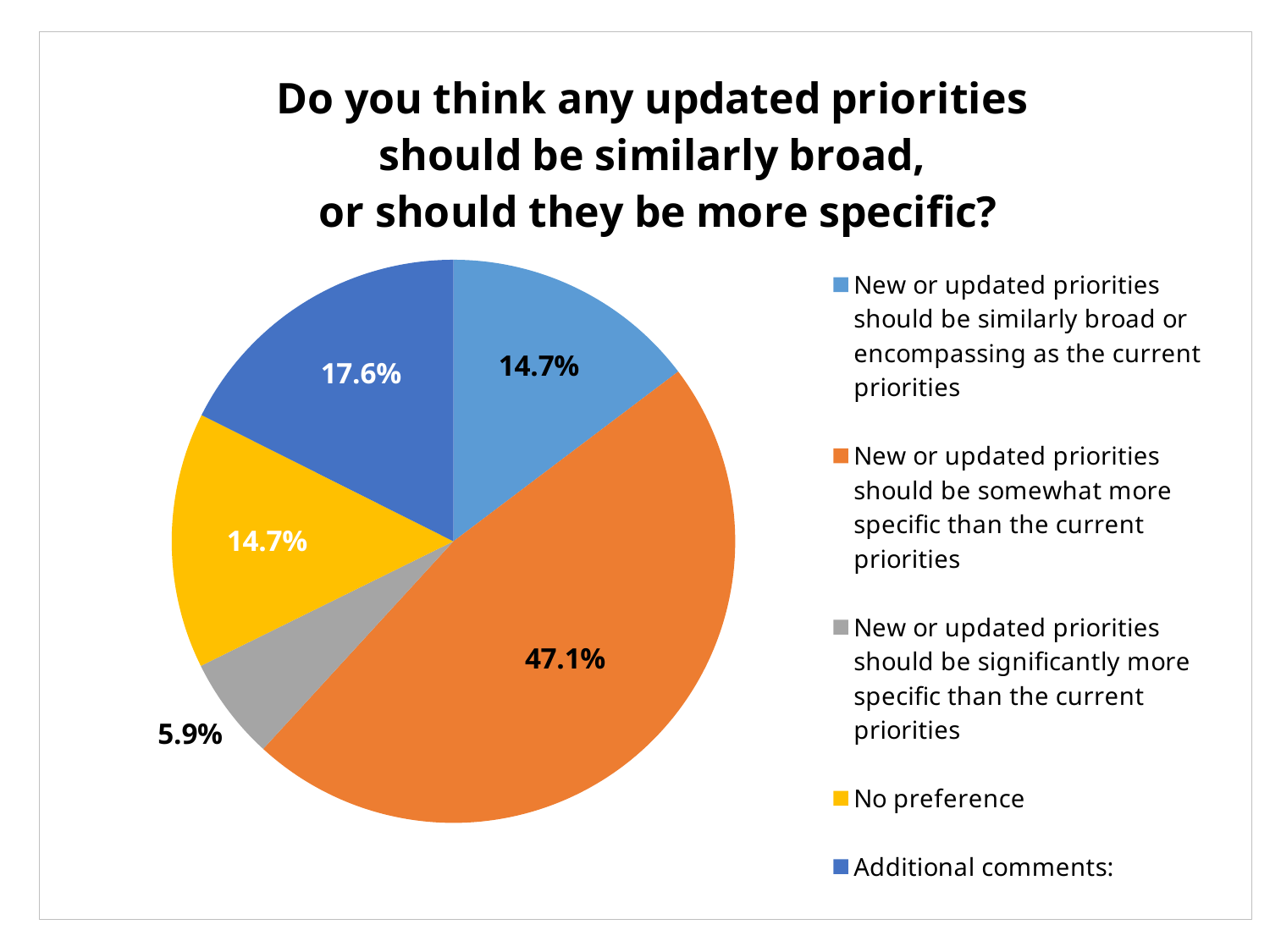
What share of respondents chose 'No preference'? 14.7% What share of respondents said new or updated priorities should be somewhat more specific than the current priorities? 47.1% What share of respondents said new or updated priorities should be significantly more specific than the current priorities? 5.9% What share of respondents said new or updated priorities should be similarly broad or encompassing as the current priorities? 14.7% What kind of chart is shown on the slide? Pie chart How many slices does the pie chart have? 5 Which is larger: the 'Additional comments:' slice or the 'No preference' slice? Additional comments: Which response option has the largest share of the pie? New or updated priorities should be somewhat more specific than the current priorities What is the difference in percentage points between the 'somewhat more specific' slice and the 'Additional comments:' slice? 29.5 percentage points What share of respondents chose 'Additional comments:'? 17.6% What colour is the slice for 'No preference'? Yellow Which response option has the smallest share of the pie? New or updated priorities should be significantly more specific than the current priorities